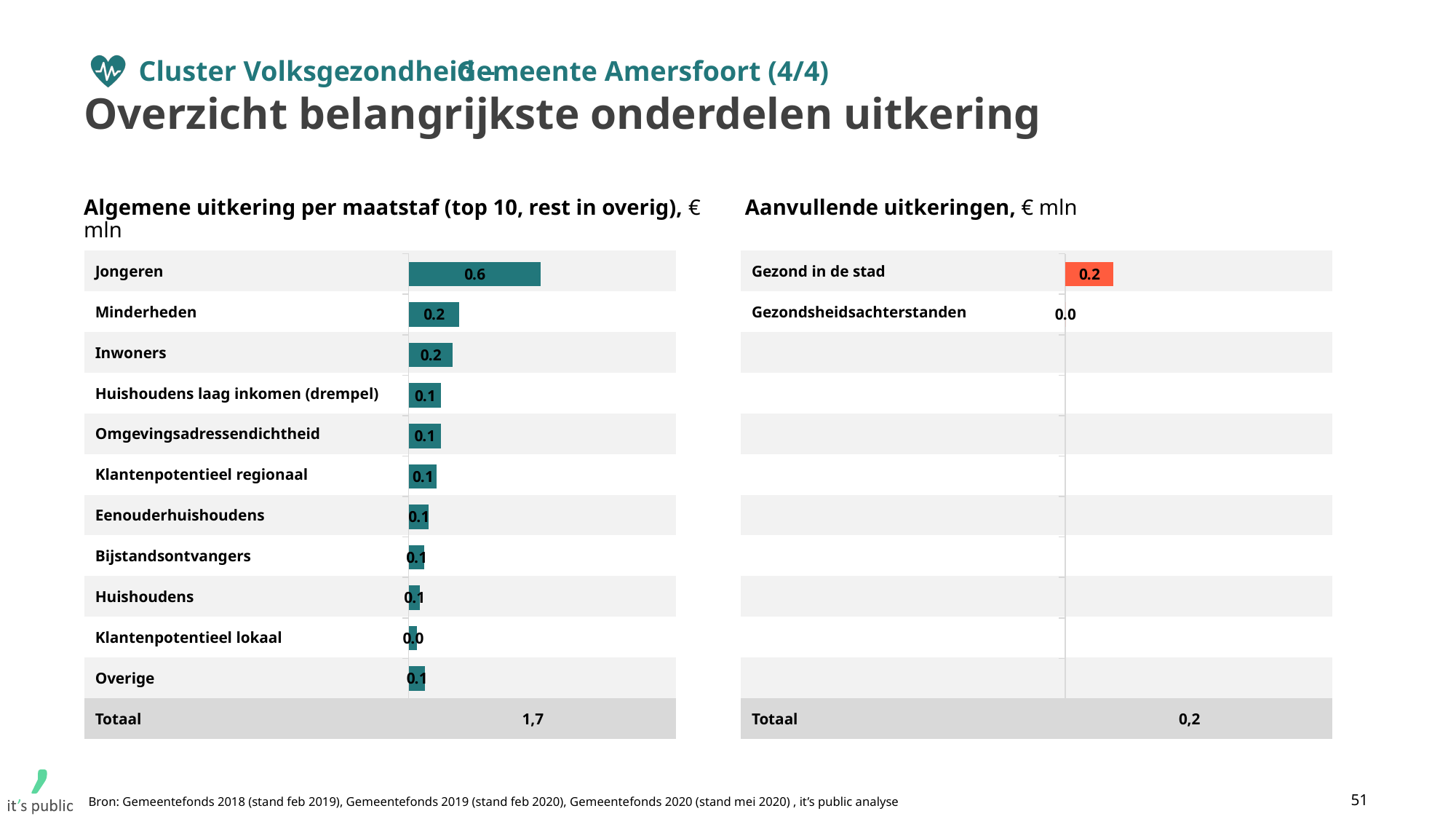
In the chart 'Algemene uitkering per maatstaf', what is the value for Jongeren? 0.6 How many categories are shown in the chart 'Algemene uitkering per maatstaf'? 11 What kind of chart is the 'Aanvullende uitkeringen' chart on the right? Bar chart In the chart 'Algemene uitkering per maatstaf', what is the difference between the values for Jongeren and Minderheden? 0.4 In the chart 'Algemene uitkering per maatstaf', which is larger: the value for Jongeren or the value for Inwoners? Jongeren In the chart 'Aanvullende uitkeringen', what is the value for Gezond in de stad? 0.2 What is the Totaal shown for the chart 'Algemene uitkering per maatstaf'? 1,7 In the chart 'Algemene uitkering per maatstaf', which category has the highest value? Jongeren In the chart 'Algemene uitkering per maatstaf', what is the value for Klantenpotentieel lokaal? 0.0 In the chart 'Algemene uitkering per maatstaf', what is the value for Minderheden? 0.2 In the chart 'Algemene uitkering per maatstaf', which category has the lowest value? Klantenpotentieel lokaal In the chart 'Aanvullende uitkeringen', which category has the highest value? Gezond in de stad